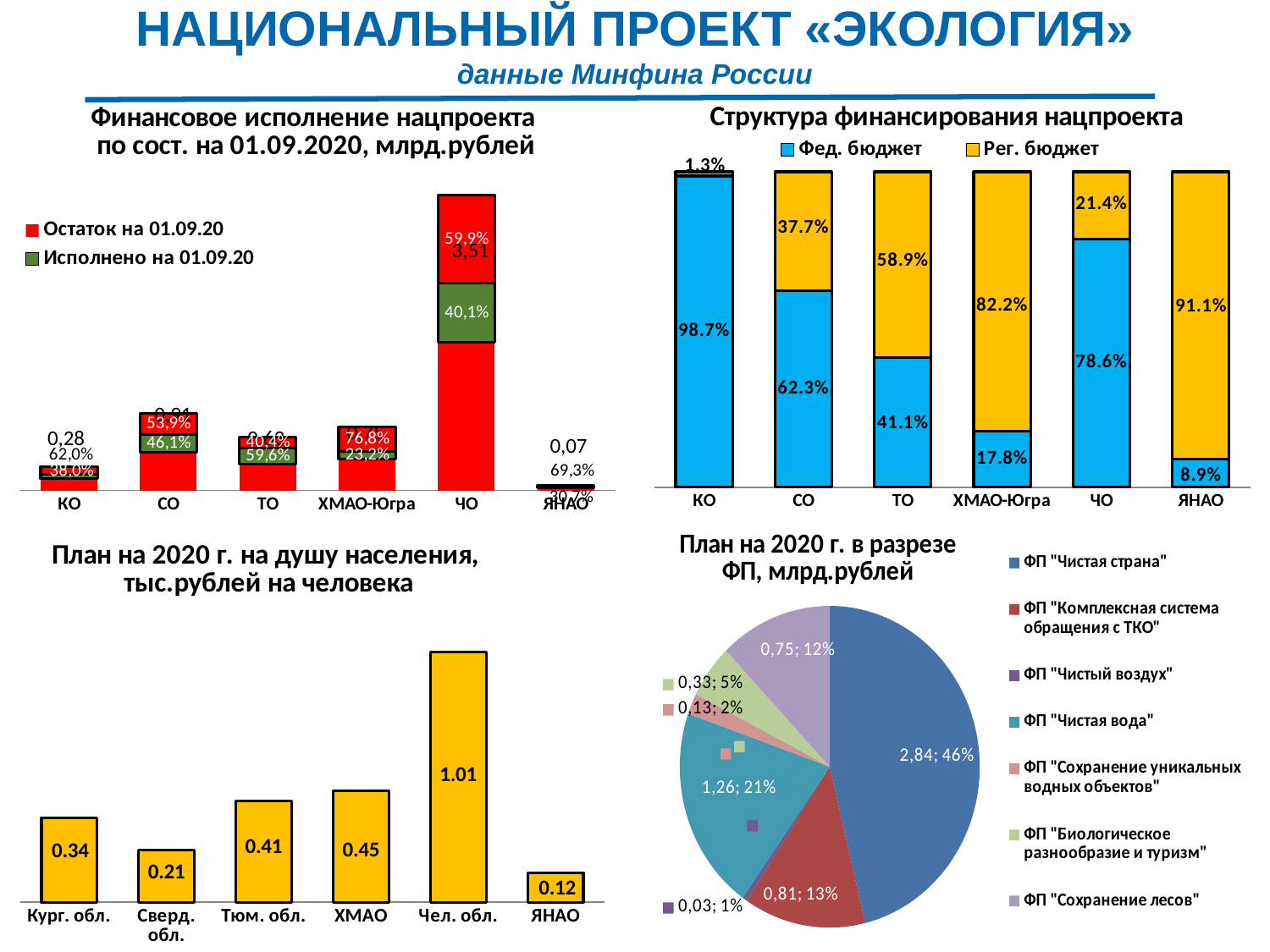
In the chart 'План на 2020 г. на душу населения, тыс.рублей на человека', what is the value for Чел. обл.? 1.01 In the chart 'Структура финансирования нацпроекта', which region has the lowest share of Фед. бюджет? ЯНАО What kind of chart is 'План на 2020 г. в разрезе ФП, млрд.рублей'? pie chart In the pie chart 'План на 2020 г. в разрезе ФП, млрд.рублей', what is the value for ФП "Чистая страна"? 2,84 In the chart 'Структура финансирования нацпроекта', what is the share of Фед. бюджет for КО? 98.7% In the chart 'План на 2020 г. на душу населения, тыс.рублей на человека', how many regions are shown? 6 In the chart 'План на 2020 г. на душу населения, тыс.рублей на человека', what is the difference between ХМАО and Тюм. обл.? 0.04 In the chart 'Структура финансирования нацпроекта', how many series does the legend list? 2 In the chart 'Структура финансирования нацпроекта', what is the share of Рег. бюджет for ЯНАО? 91.1% In the chart 'План на 2020 г. на душу населения, тыс.рублей на человека', which region has the lowest value? ЯНАО In the pie chart 'План на 2020 г. в разрезе ФП, млрд.рублей', what share does ФП "Чистая вода" have? 21% In the chart 'Финансовое исполнение нацпроекта по сост. на 01.09.2020, млрд.рублей', which region has the highest total value? ЧО